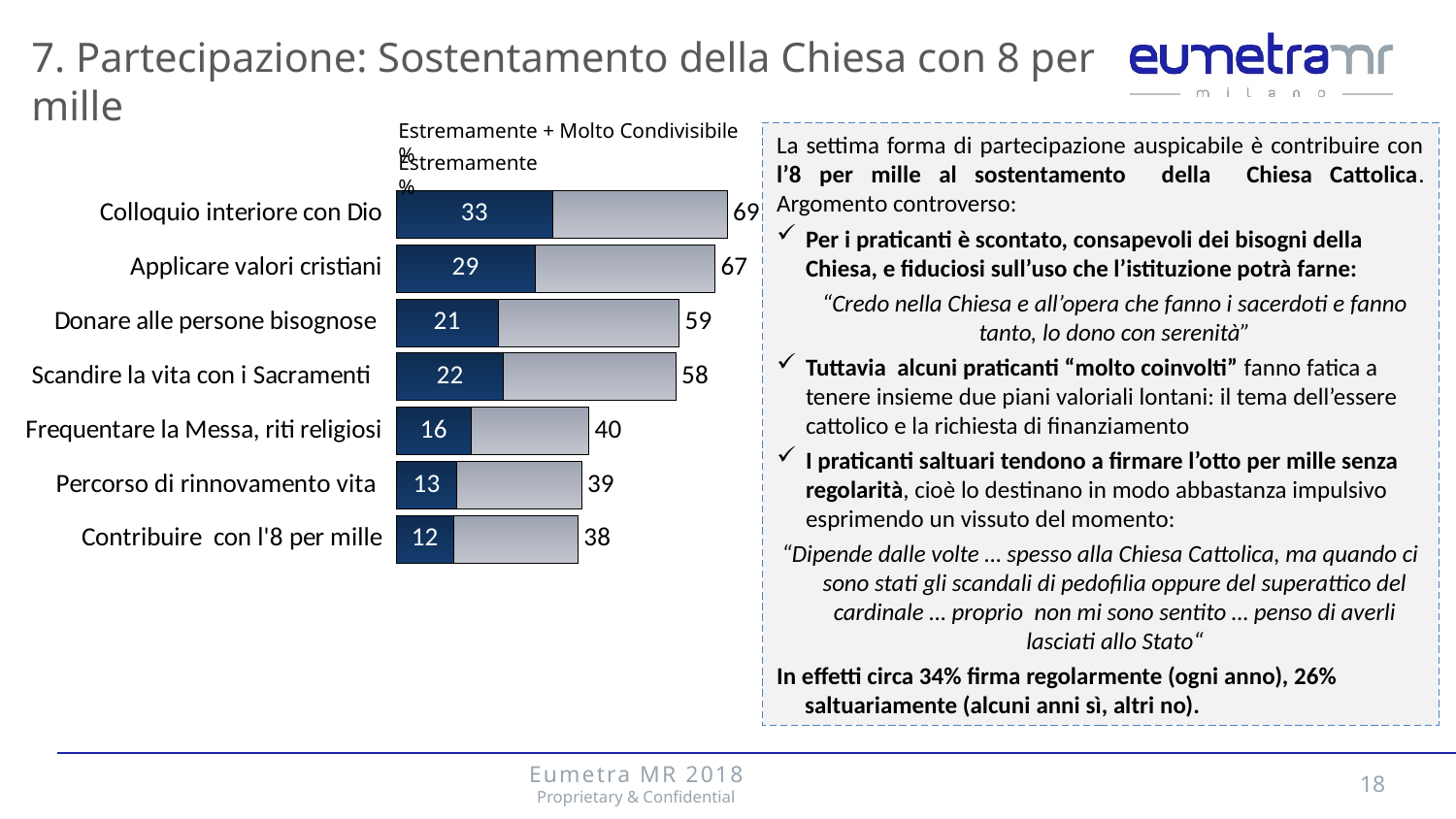
What is the 'Estremamente + Molto Condivisibile' value for 'Donare alle persone bisognose'? 59 What is the 'Estremamente' value for 'Frequentare la Messa, riti religiosi'? 16 Which has a larger 'Estremamente' value: 'Donare alle persone bisognose' or 'Scandire la vita con i Sacramenti'? Scandire la vita con i Sacramenti What is the difference between the 'Estremamente' values for 'Applicare valori cristiani' and 'Percorso di rinnovamento vita'? 16 What is the difference between the 'Estremamente + Molto Condivisibile' values for 'Colloquio interiore con Dio' and 'Contribuire con l'8 per mille'? 31 Which category has the lowest 'Estremamente' value? Contribuire con l'8 per mille Which category has the highest 'Estremamente + Molto Condivisibile' value? Colloquio interiore con Dio What is the 'Estremamente' value for 'Colloquio interiore con Dio'? 33 What is the 'Estremamente + Molto Condivisibile' value for 'Contribuire con l'8 per mille'? 38 How many categories are shown in the chart? 7 What kind of chart is shown on the slide? Bar chart